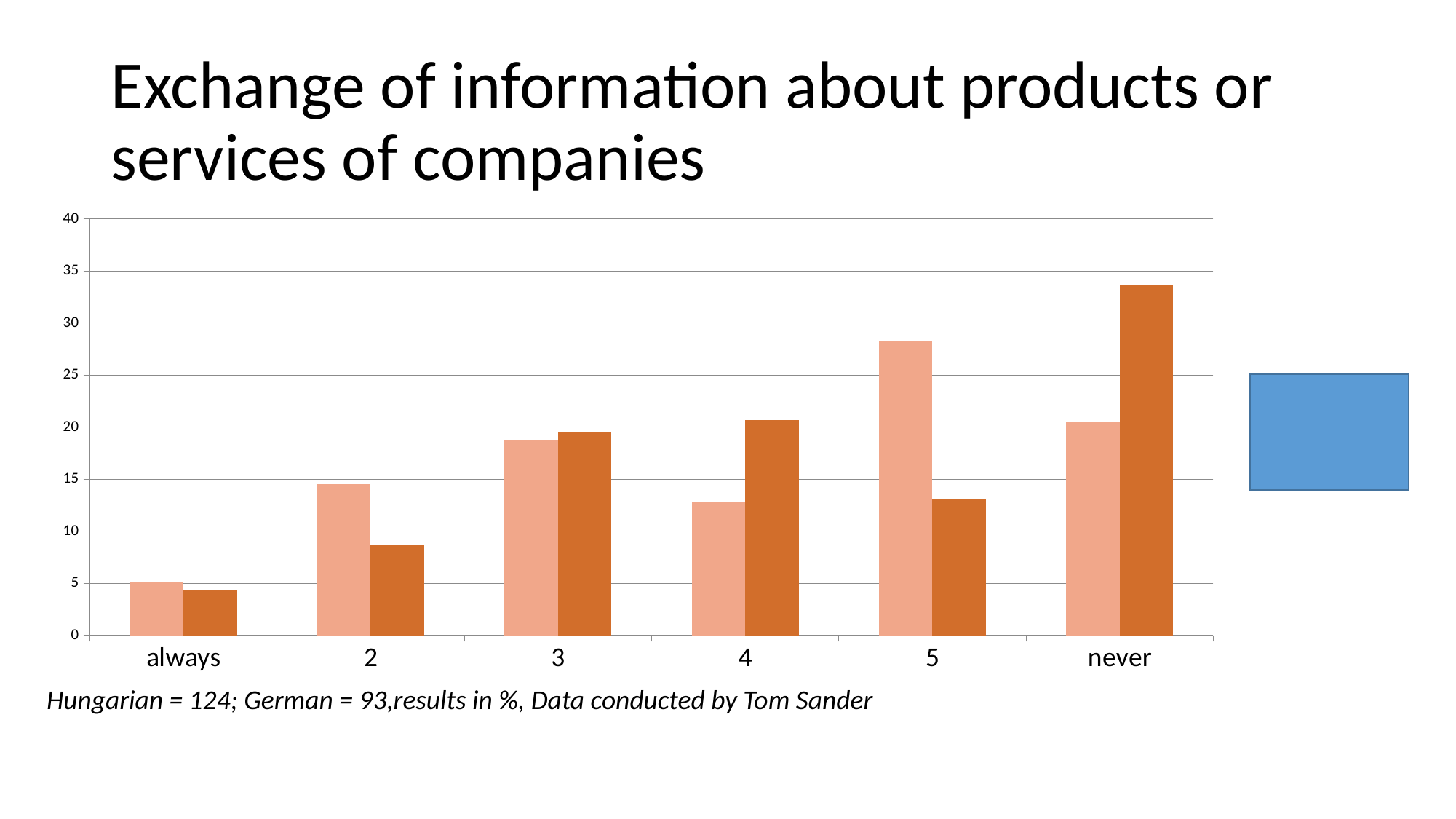
How many categories are shown on the x axis? 6 Is the light orange value for '5' greater or less than 25? greater For which category is the dark orange bar the highest? never For which category is the light orange bar the lowest? always For the category '5', which bar is larger, the light orange or the dark orange? light orange For the category '4', which bar is larger, the light orange or the dark orange? dark orange What kind of chart is shown on the slide? bar chart Is the dark orange value for '2' greater or less than 10? less How many bars are plotted for each category? 2 For which category is the light orange bar the highest? 5 What is the title of the slide containing the chart? Exchange of information about products or services of companies Is the dark orange value for 'never' greater or less than 30? greater